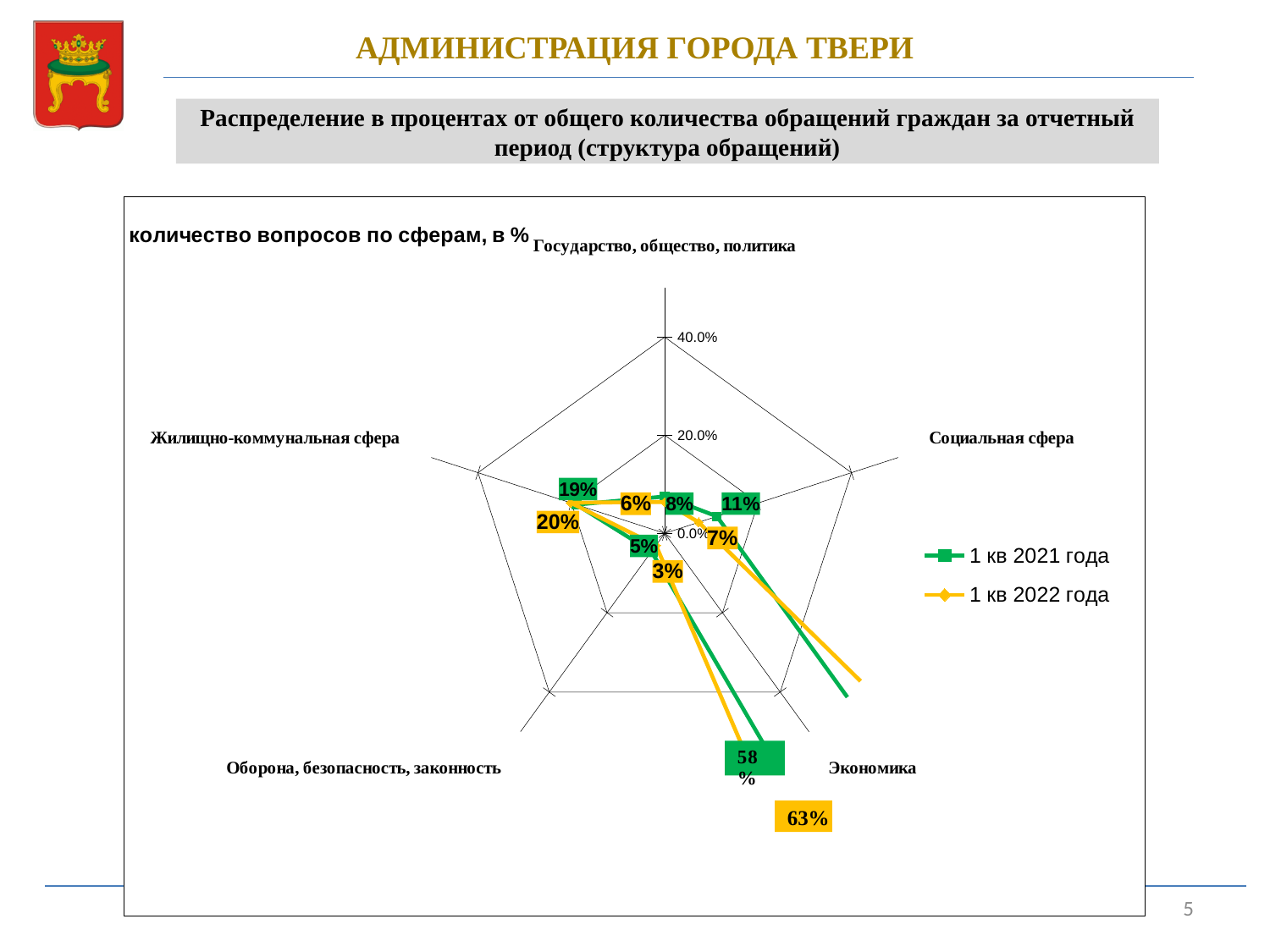
What is the value for Экономика in the series 1 кв 2022 года? 63% What is the value for Социальная сфера in the series 1 кв 2021 года? 11% What is the value for Жилищно-коммунальная сфера in the series 1 кв 2022 года? 20% What is the value for Государство, общество, политика in the series 1 кв 2022 года? 6% What is the value for Экономика in the series 1 кв 2021 года? 58% By how many percentage points does the value for Экономика in 1 кв 2022 года exceed the value in 1 кв 2021 года? 5 How many series does the legend list? 2 What are the two series named in the legend? 1 кв 2021 года and 1 кв 2022 года What kind of chart is shown on the slide? Radar chart Which category has the highest value in the series 1 кв 2022 года? Экономика For Социальная сфера, which series has the larger value: 1 кв 2021 года or 1 кв 2022 года? 1 кв 2021 года How many categories (spheres) are plotted on the radar chart? 5